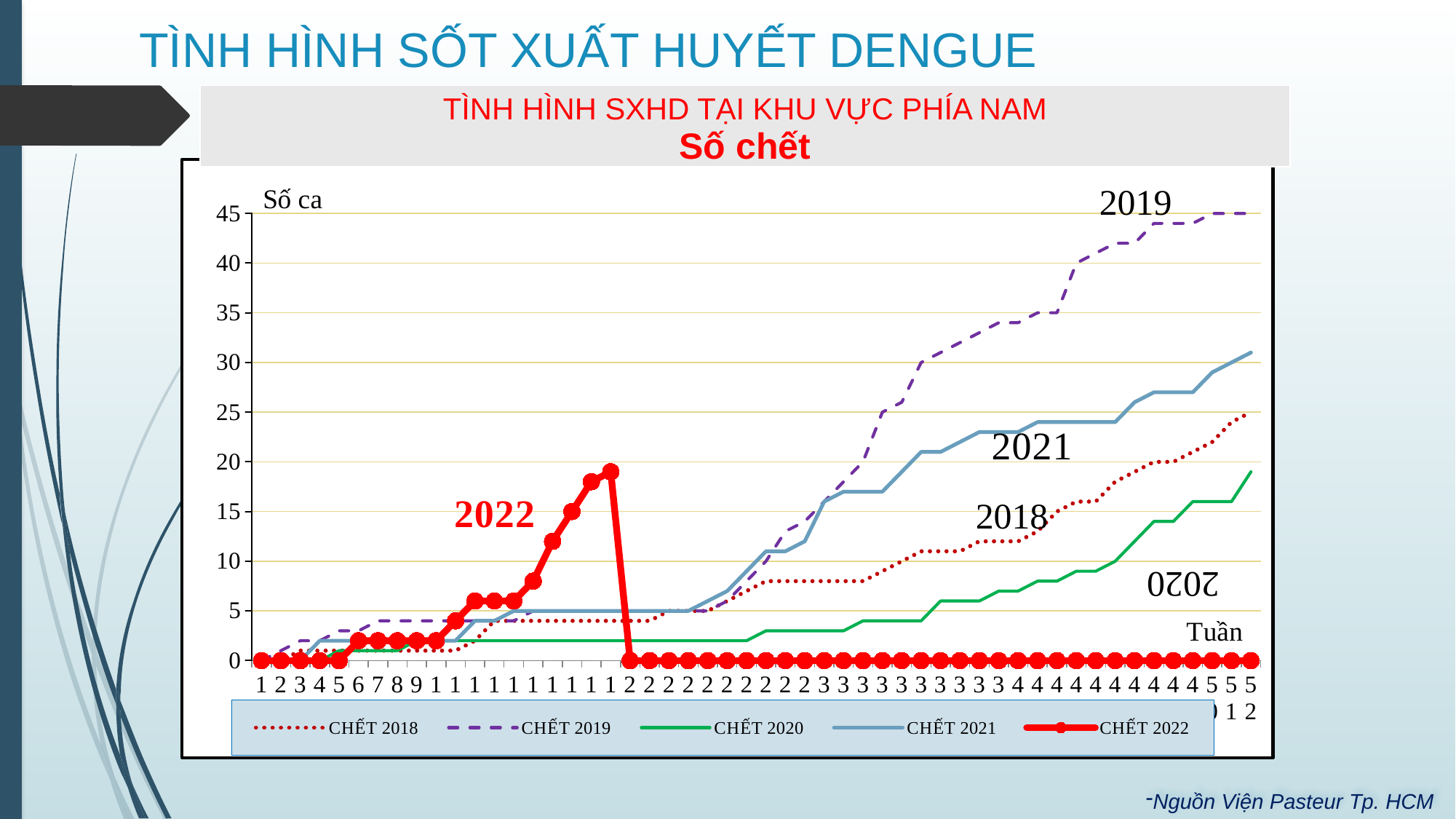
Is the peak value of the CHẾT 2022 series greater or less than 15? greater What is the label of the vertical axis? Số ca Is the final value of the CHẾT 2020 series greater or less than 20? less Which series reaches the highest value at the end of the year (week 52)? CHẾT 2019 At week 52, which is larger: the value for CHẾT 2021 or the value for CHẾT 2018? CHẾT 2021 What value does the CHẾT 2022 series show from week 20 onward? 0 Does the CHẾT 2019 series rise or fall across the weeks? rise Which series has the lowest value at week 52? CHẾT 2022 Is the final value of the CHẾT 2019 series greater or less than 40? greater What kind of chart is shown on the slide? line chart How many series does the legend list? 5